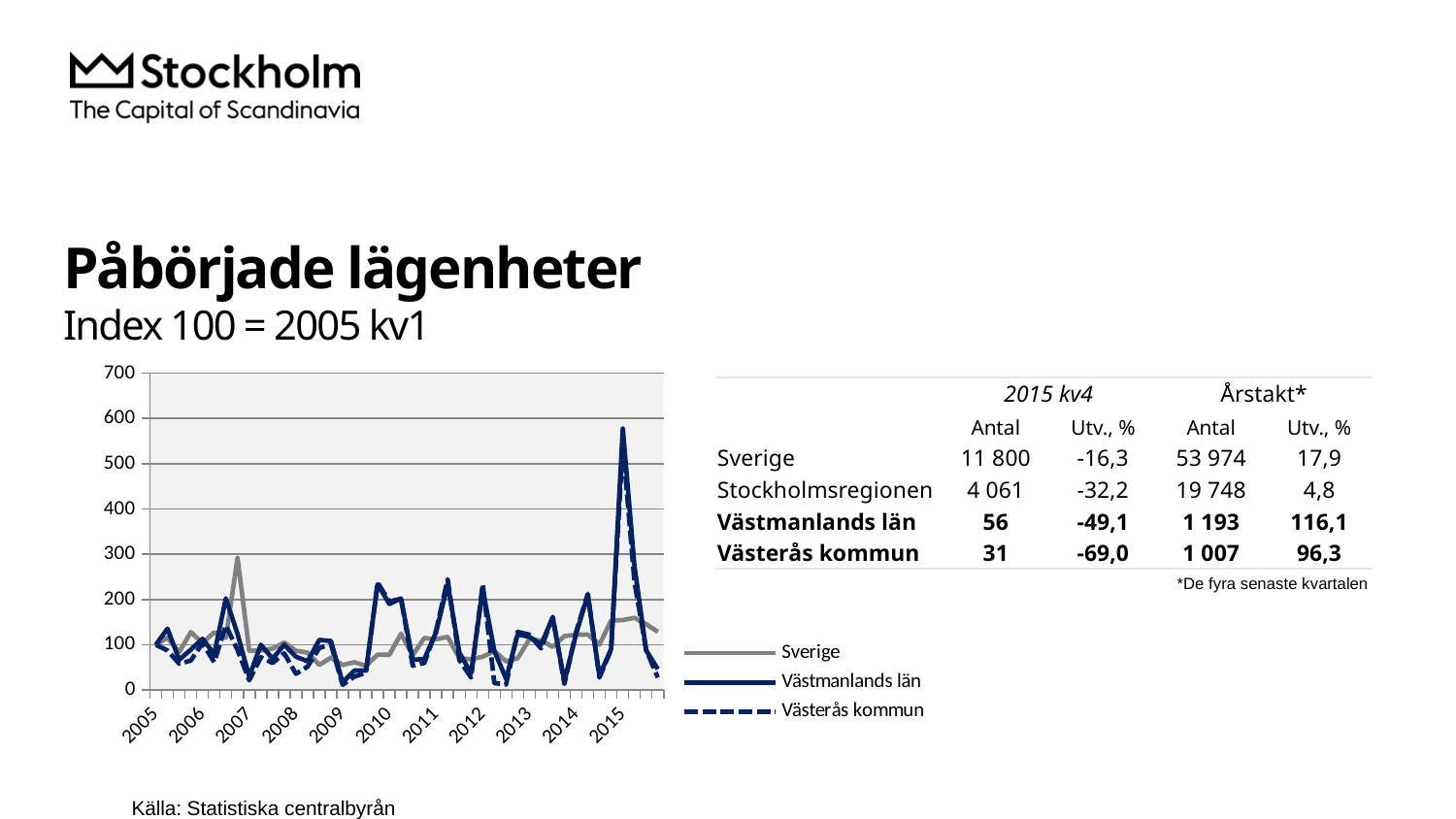
What kind of chart is shown on the slide? line chart Which series is drawn with a dashed line in the chart? Västerås kommun Is the value for Sverige at the start of 2009 greater or less than 100? less Which series reaches the highest peak in the chart? Västmanlands län Is the value for Sverige at the end of 2015 greater or less than 100? greater How many series does the chart legend list? 3 Which series is drawn in grey in the chart? Sverige What is the first year shown on the x axis of the chart? 2005 Which series reaches the highest value in 2015: Sverige or Västmanlands län? Västmanlands län Is the highest value reached by Västmanlands län in 2015 greater or less than 500? greater